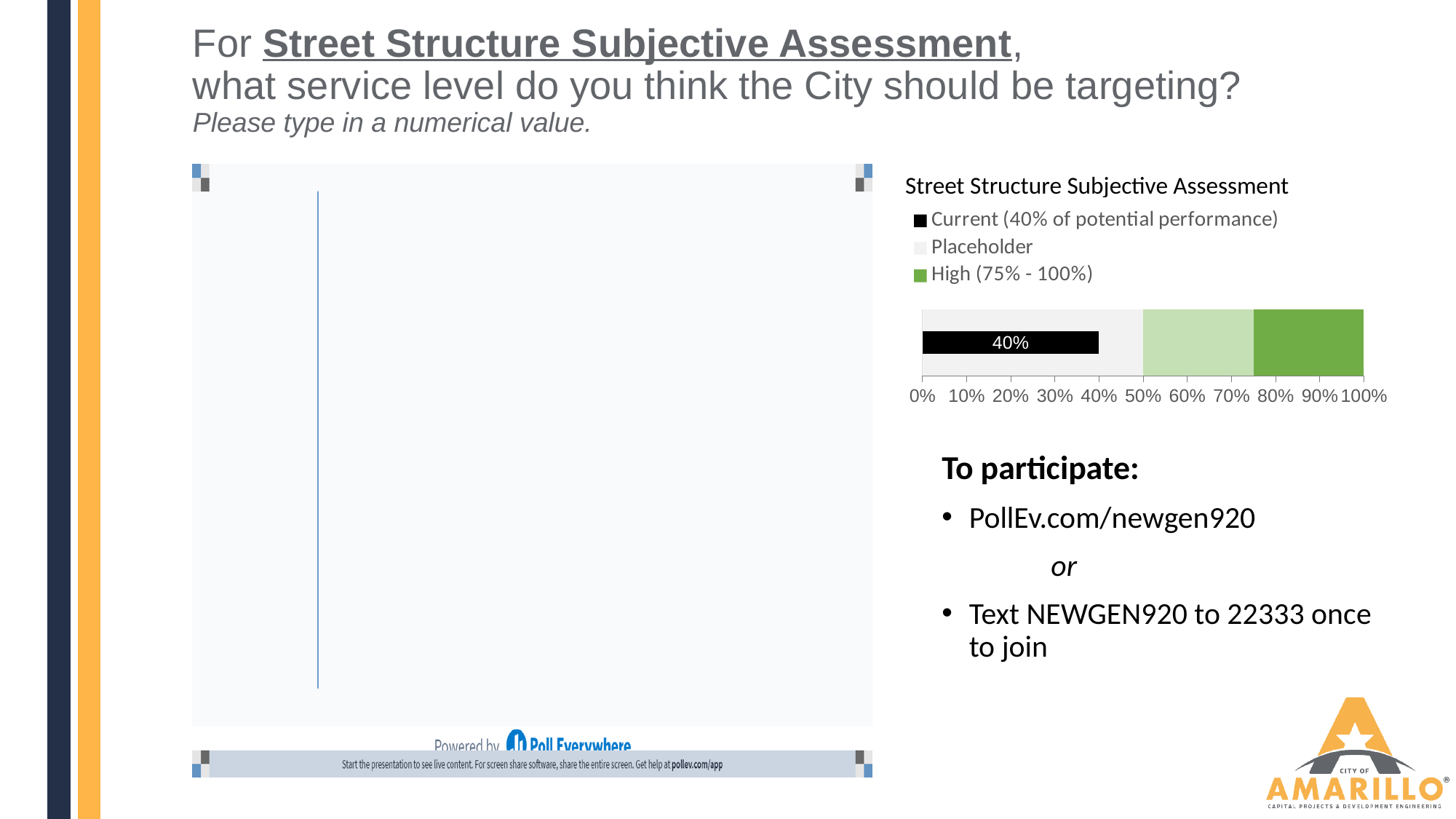
What kind of chart is the Street Structure Subjective Assessment chart? bar chart Is the value of the Current bar in the Street Structure Subjective Assessment chart greater or less than 50%? less What value is printed on the black bar in the Street Structure Subjective Assessment chart? 40% What is the full legend label for the black series in the Street Structure Subjective Assessment chart? Current (40% of potential performance) What is the title of the chart on the right side of the slide? Street Structure Subjective Assessment Is the value of the Current bar in the Street Structure Subjective Assessment chart greater or less than 30%? greater How many series does the legend of the Street Structure Subjective Assessment chart list? 3 Which legend entry in the Street Structure Subjective Assessment chart is shown in green? High (75% - 100%)